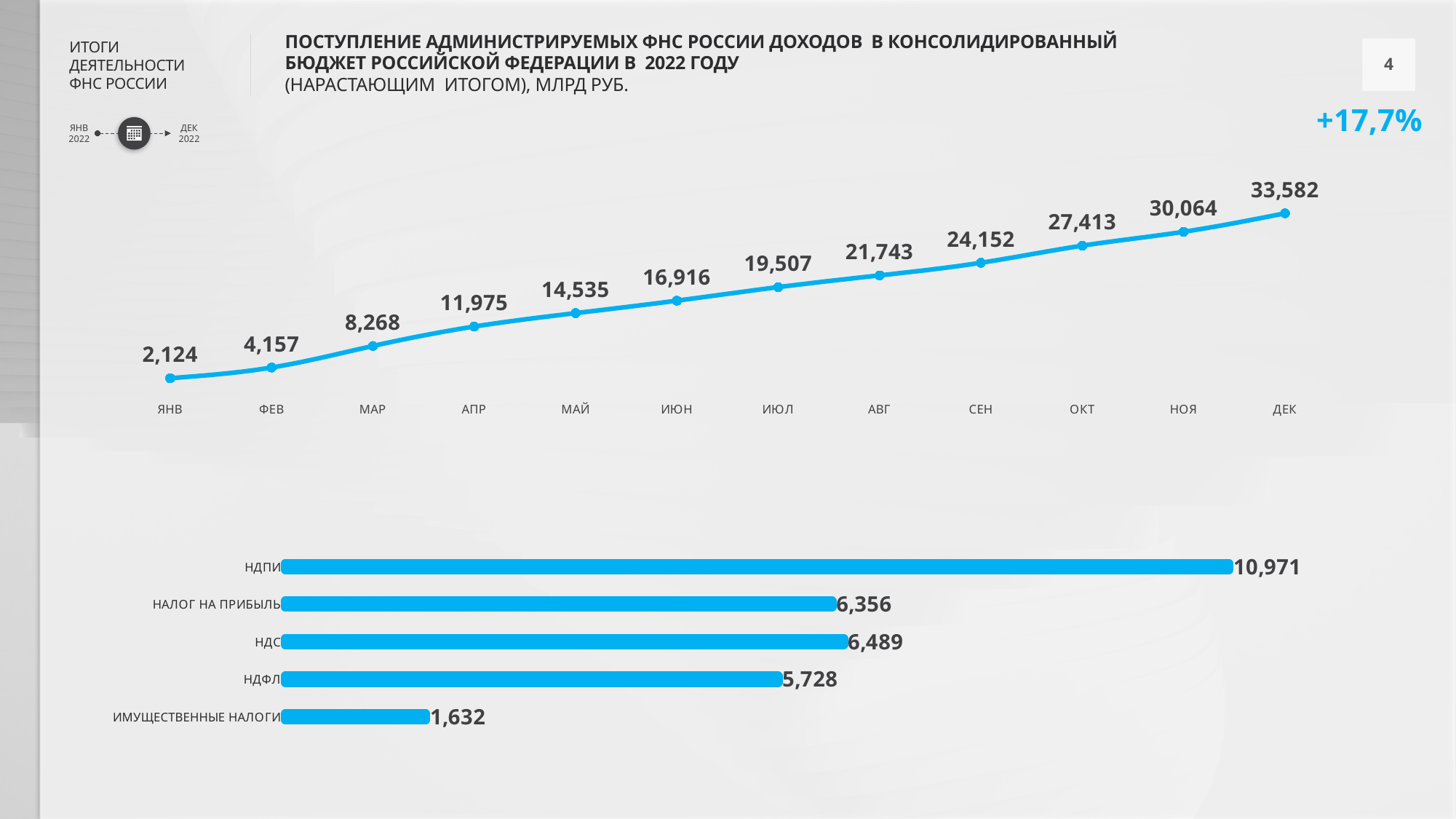
In the bottom bar chart, which category has the highest value? НДПИ In the top line chart, do the values rise or fall from ЯНВ to ДЕК? rise In the top line chart, what is the value for ДЕК? 33,582 In the top line chart, what is the value for МАР? 8,268 In the top line chart, what is the value for ИЮЛ? 19,507 In the bottom bar chart, what is the value for НДФЛ? 5,728 In the bottom bar chart, which is larger: НДС or НАЛОГ НА ПРИБЫЛЬ? НДС In the top line chart, which month has the lowest value? ЯНВ In the bottom bar chart, what is the difference between НДПИ and ИМУЩЕСТВЕННЫЕ НАЛОГИ? 9,339 In the top line chart, how many data points are plotted? 12 In the top line chart, what is the difference between the values for ДЕК and НОЯ? 3,518 What kind of chart is the top chart on the slide? line chart